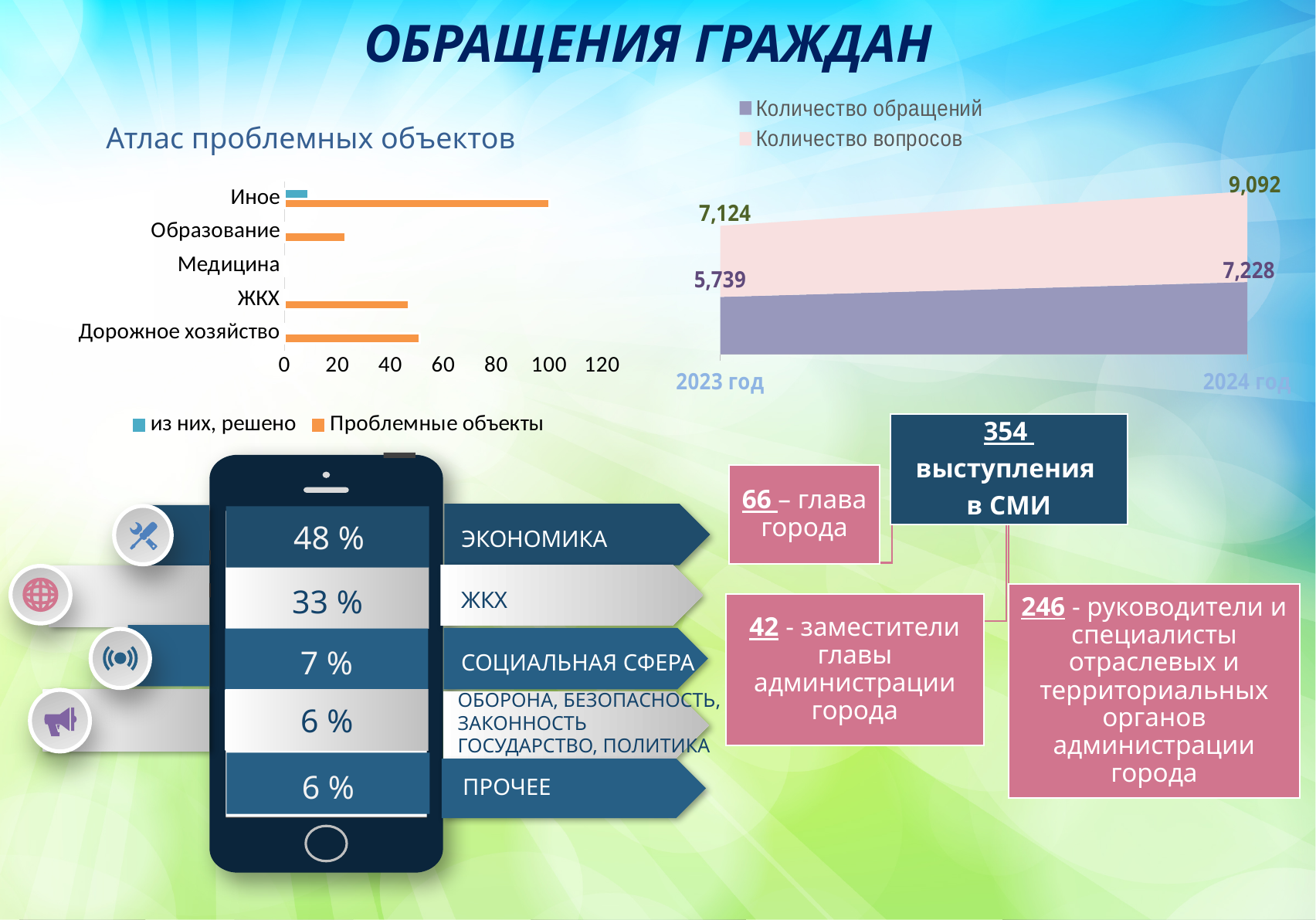
In the right-hand area chart, what is the value of Количество вопросов for 2023 год? 7,124 In the right-hand area chart, by how much did Количество вопросов increase from 2023 год to 2024 год? 1,968 What kind of chart is 'Атлас проблемных объектов'? bar chart In the 'Атлас проблемных объектов' chart, which has a larger value for Проблемные объекты: Дорожное хозяйство or Образование? Дорожное хозяйство How many categories are shown in the 'Атлас проблемных объектов' chart? 5 In the right-hand area chart, what is the difference between Количество обращений in 2024 год and 2023 год? 1,489 In the right-hand area chart, what is the value of Количество обращений for 2024 год? 7,228 In the 'Атлас проблемных объектов' chart, which category has the highest value for Проблемные объекты? Иное How many series does the legend of the right-hand area chart list? 2 In the right-hand area chart, do the values of Количество обращений rise or fall from 2023 год to 2024 год? rise In the right-hand area chart, what is the value of Количество обращений for 2023 год? 5,739 In the 'Атлас проблемных объектов' chart, is the value of Проблемные объекты for Иное greater or less than 80? greater